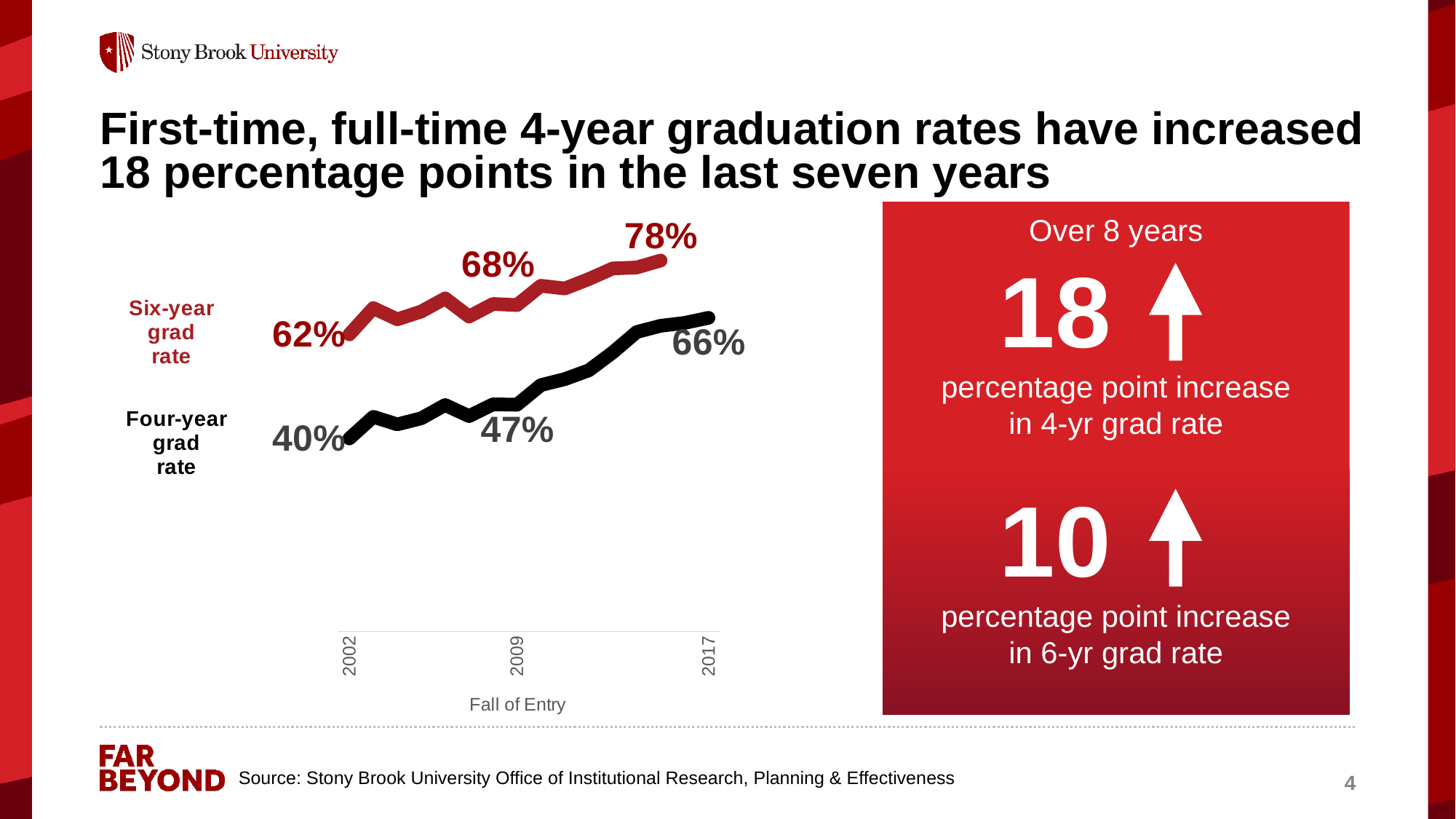
Which series is higher for the 2009 cohort, the six-year grad rate or the four-year grad rate? Six-year grad rate What was the six-year grad rate for the 2002 fall of entry cohort? 62% What was the four-year grad rate for the 2002 fall of entry cohort? 40% What was the six-year grad rate for the 2009 fall of entry cohort? 68% By how many percentage points did the four-year grad rate rise between the 2002 and 2009 cohorts? 7 percentage points What was the four-year grad rate for the 2009 fall of entry cohort? 47% What is the gap between the six-year and four-year grad rates for the 2002 cohort? 22 percentage points How many data series are plotted on the chart? 2 What is the highest labelled value on the four-year grad rate line? 66% What is the title of the x axis of the chart? Fall of Entry What is the highest labelled value on the six-year grad rate line? 78% What type of chart is shown on the slide? Line chart